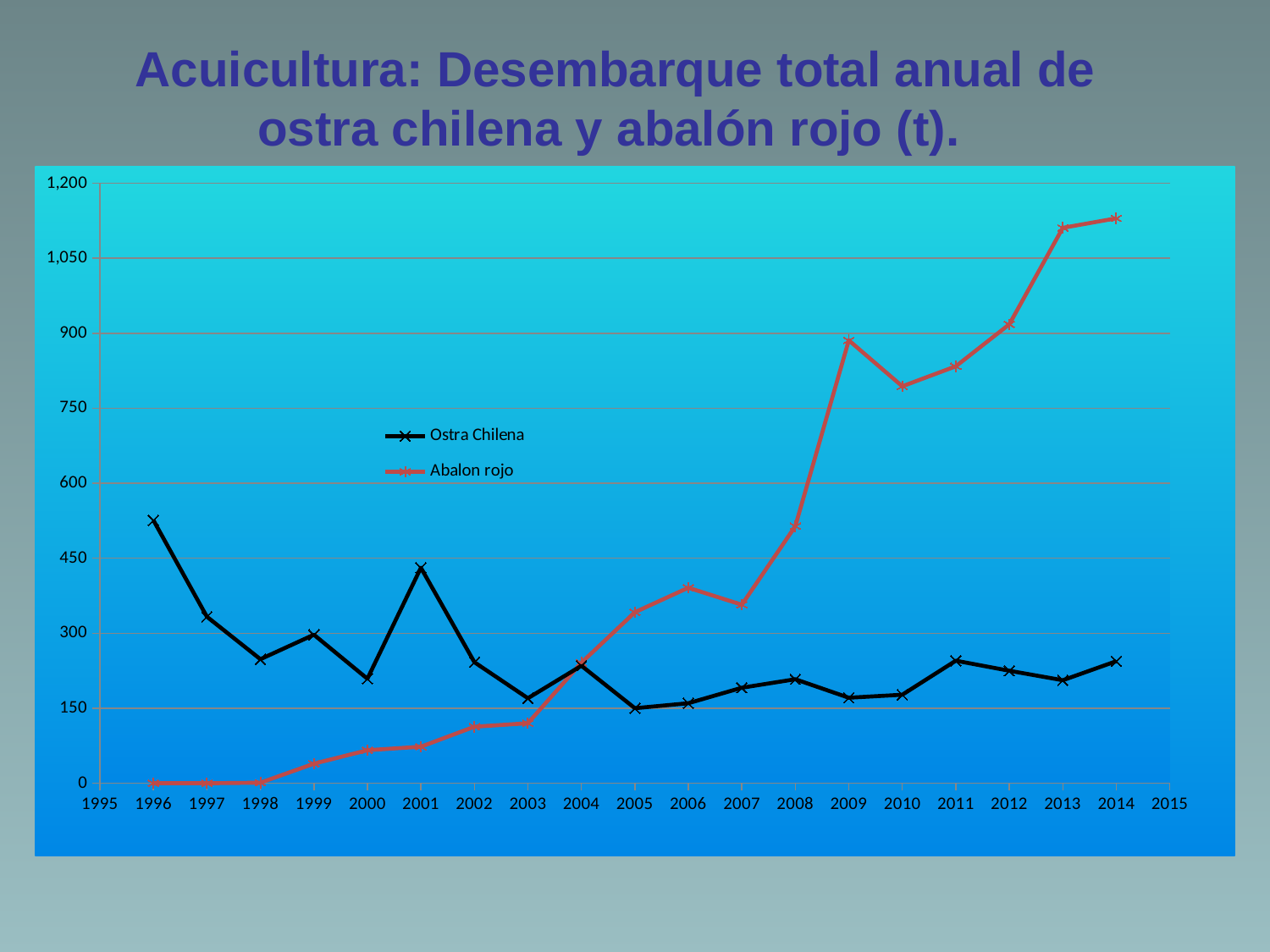
Is the value for Abalon rojo in 2014 greater or less than 1,050? greater Is the value for Ostra Chilena in 2001 greater or less than 300? greater In which year does the Ostra Chilena series reach its highest value? 1996 In 2008, which series has the larger value, Ostra Chilena or Abalon rojo? Abalon rojo Is the value for Abalon rojo in 2009 greater or less than 750? greater What kind of chart is shown on the slide? line chart What are the two series named in the legend? Ostra Chilena and Abalon rojo How many series does the legend list? 2 What is the value for Abalon rojo in 1996? 0 Does the Abalon rojo series overall rise or fall from 1996 to 2014? rise What colour is the Abalon rojo line? red